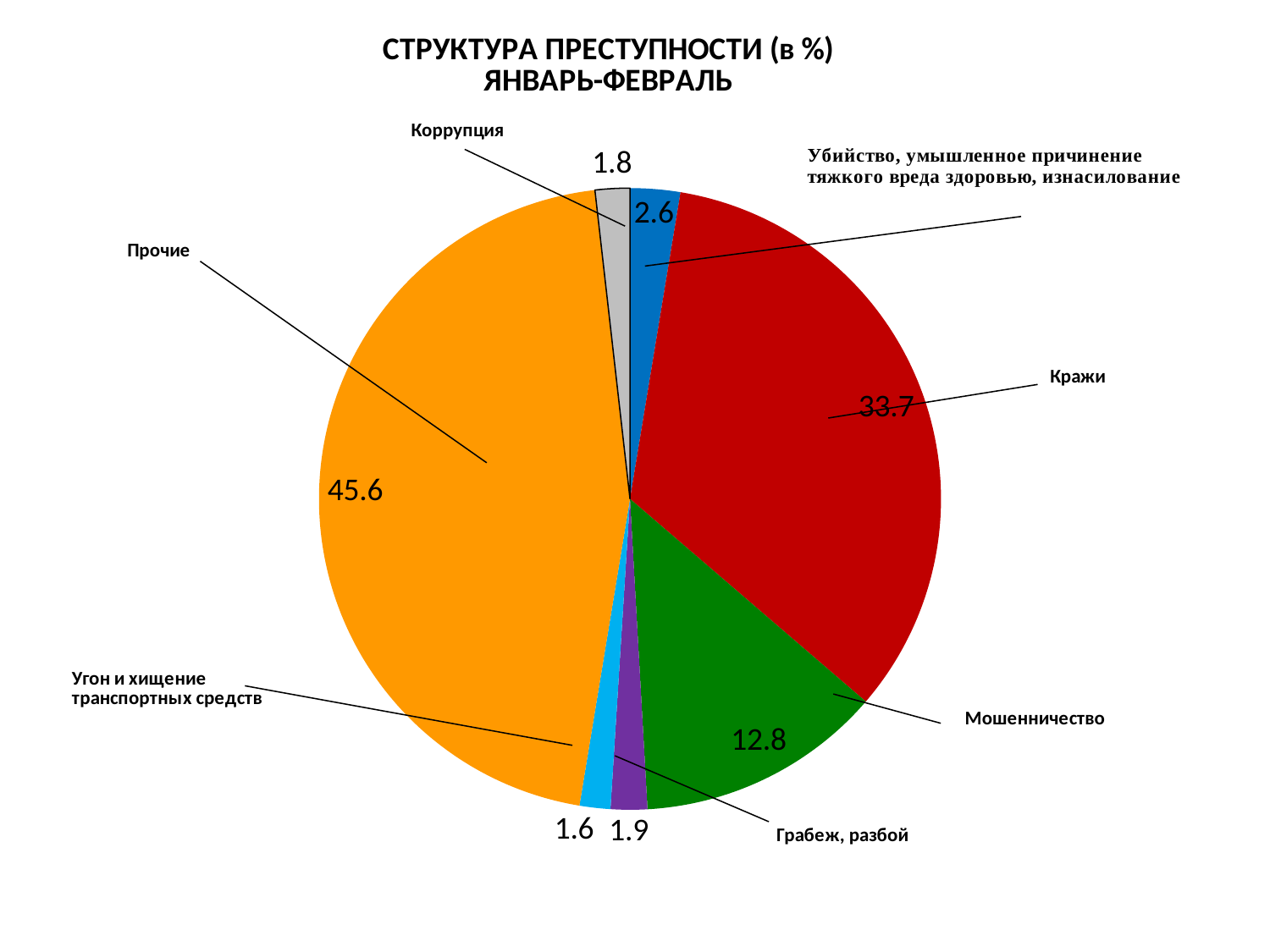
Which is larger, Грабеж, разбой or Коррупция? Грабеж, разбой What is the value for Кражи? 33.7 How many slices does the pie chart have? 7 What is the difference between the values for Прочие and Кражи? 11.9 What is the value for Прочие? 45.6 What is the value for Коррупция? 1.8 Which category has the smallest slice? Угон и хищение транспортных средств Which category has the largest slice? Прочие What is the value for Мошенничество? 12.8 What is the value for Угон и хищение транспортных средств? 1.6 What is the title of the chart? СТРУКТУРА ПРЕСТУПНОСТИ (в %) ЯНВАРЬ-ФЕВРАЛЬ What kind of chart is shown on the slide? pie chart